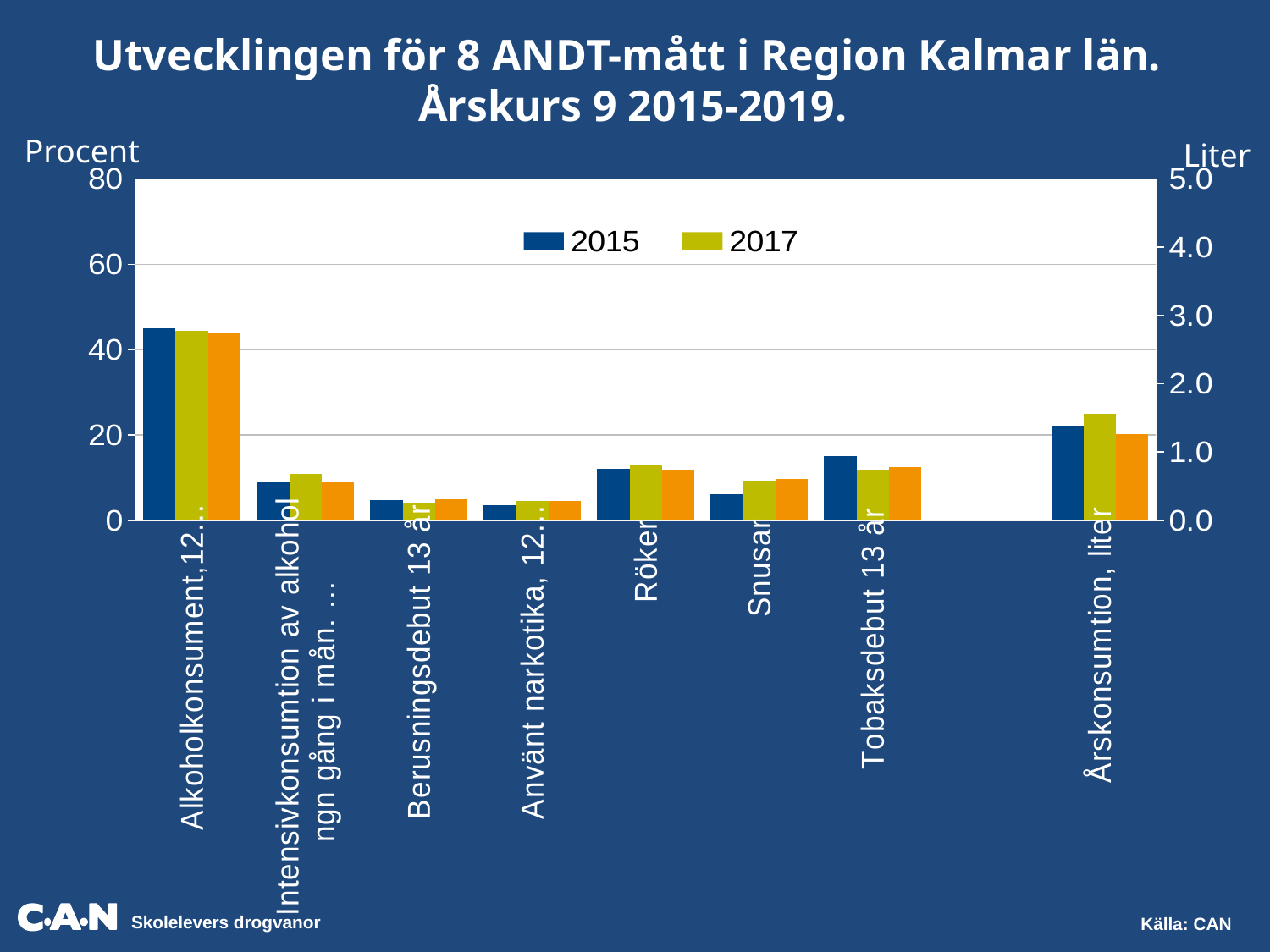
Which category has the highest bars in the chart? Alkoholkonsument,12... Is the 2015 value for Alkoholkonsument greater or less than 40? greater Is the 2015 value for Röker greater or less than 20? less How many categories are shown along the x axis of the chart? 8 Which series is shown in dark blue in the legend? 2015 What kind of chart is shown on the slide? bar chart How many series does the chart's legend list? 2 Which has the larger 2015 value, Röker or Snusar? Röker Is the 2017 value for Snusar greater or less than 20? less What is the label of the left vertical axis? Procent Which has the larger 2015 value, Alkoholkonsument or Tobaksdebut 13 år? Alkoholkonsument What is the label of the right vertical axis? Liter